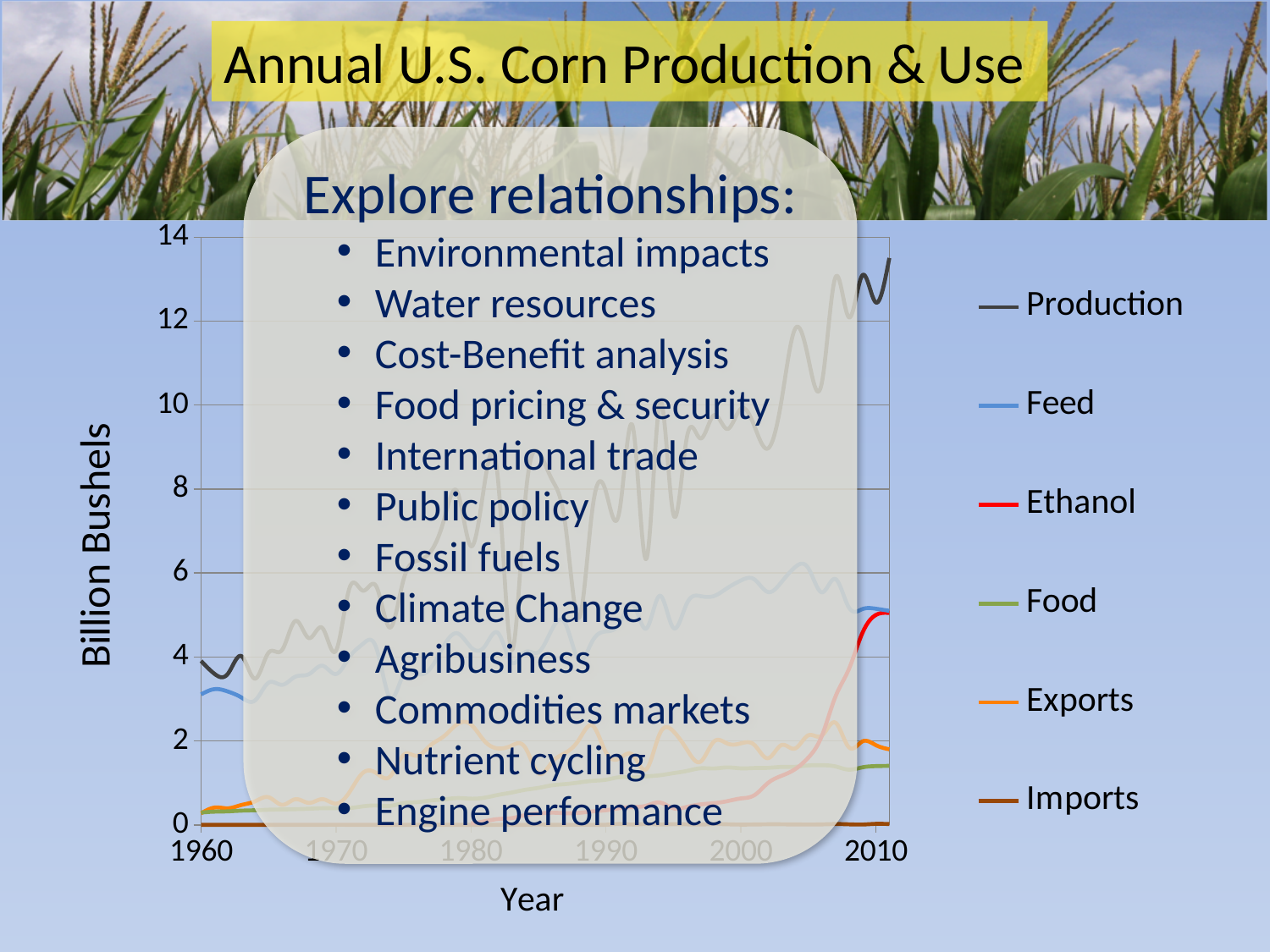
Is the value for Food around 2010 greater or less than 2? less Is the value for Production around 2010 greater or less than 12? greater What kind of chart is shown on the slide? line chart Does the Production series generally rise or fall from 1960 to 2010? rise What is the label on the vertical axis of the chart? Billion Bushels Is the value for Imports around 2010 greater or less than 2? less What is the title of the chart? Annual U.S. Corn Production & Use How many series does the legend list? 6 Which series has the lowest value around 2010? Imports Around 2010, which is larger, Production or Ethanol? Production Which series has the highest value around 2010? Production